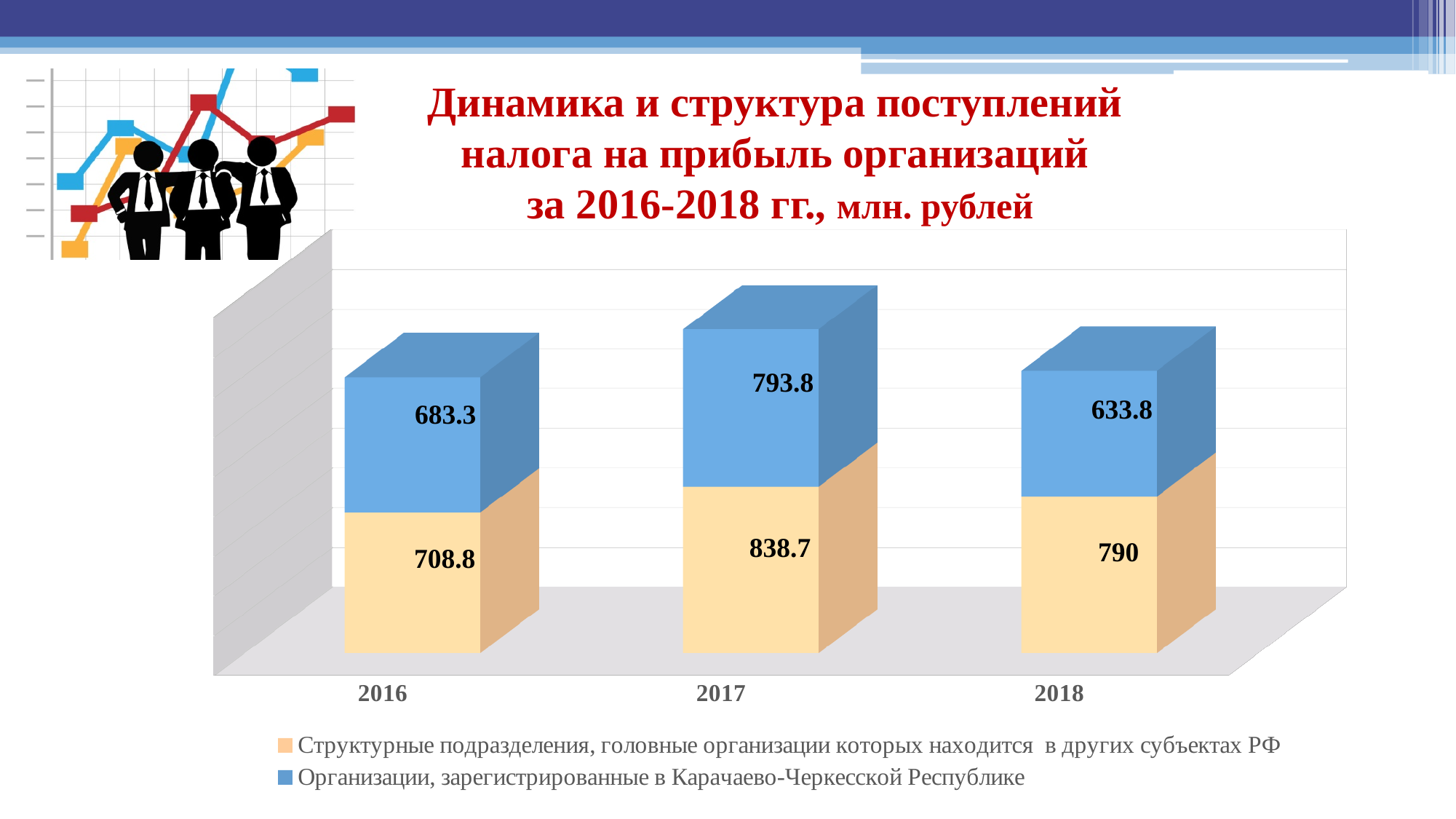
What is the value for 'Организации, зарегистрированные в Карачаево-Черкесской Республике' in 2016? 683.3 How many series does the legend list? 2 What is the total of the stacked bar for 2017? 1632.5 What is the value for 'Организации, зарегистрированные в Карачаево-Черкесской Республике' in 2017? 793.8 In which year is the value for 'Организации, зарегистрированные в Карачаево-Черкесской Республике' the lowest? 2018 In which year is the value for 'Структурные подразделения, головные организации которых находится в других субъектах РФ' the highest? 2017 How many years are shown on the x axis? 3 What is the difference between the 2017 and 2016 values for 'Структурные подразделения, головные организации которых находится в других субъектах РФ'? 129.9 What kind of chart is shown on the slide? Stacked bar chart What is the value for 'Структурные подразделения, головные организации которых находится в других субъектах РФ' in 2018? 790 Which is larger in 2018: the value for 'Структурные подразделения, головные организации которых находится в других субъектах РФ' or for 'Организации, зарегистрированные в Карачаево-Черкесской Республике'? Структурные подразделения, головные организации которых находится в других субъектах РФ What is the total of the stacked bar for 2016? 1392.1